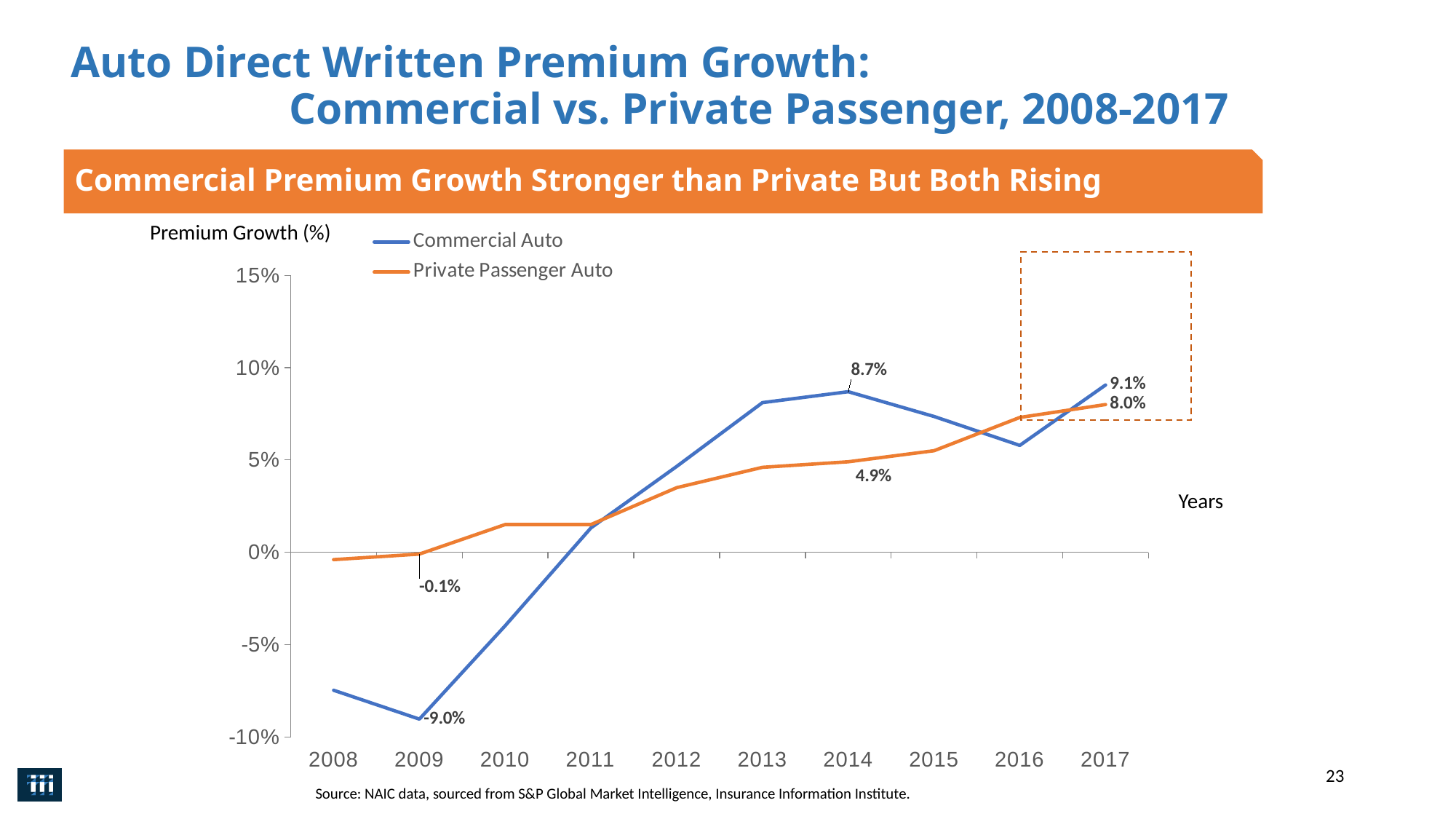
What was the Private Passenger Auto premium growth in 2014? 4.9% What was the Commercial Auto premium growth in 2009? -9.0% What kind of chart is shown on the slide? line chart What was the Private Passenger Auto premium growth in 2009? -0.1% In which year was Commercial Auto premium growth highest? 2017 What is the difference between Commercial Auto and Private Passenger Auto premium growth in 2014? 3.8 percentage points How many series does the legend list? 2 What was the Commercial Auto premium growth in 2017? 9.1% Is the Commercial Auto premium growth in 2008 greater or less than -5%? less How many years are shown on the x axis? 10 Which series had higher premium growth in 2016, Commercial Auto or Private Passenger Auto? Private Passenger Auto In which year was Commercial Auto premium growth lowest? 2009